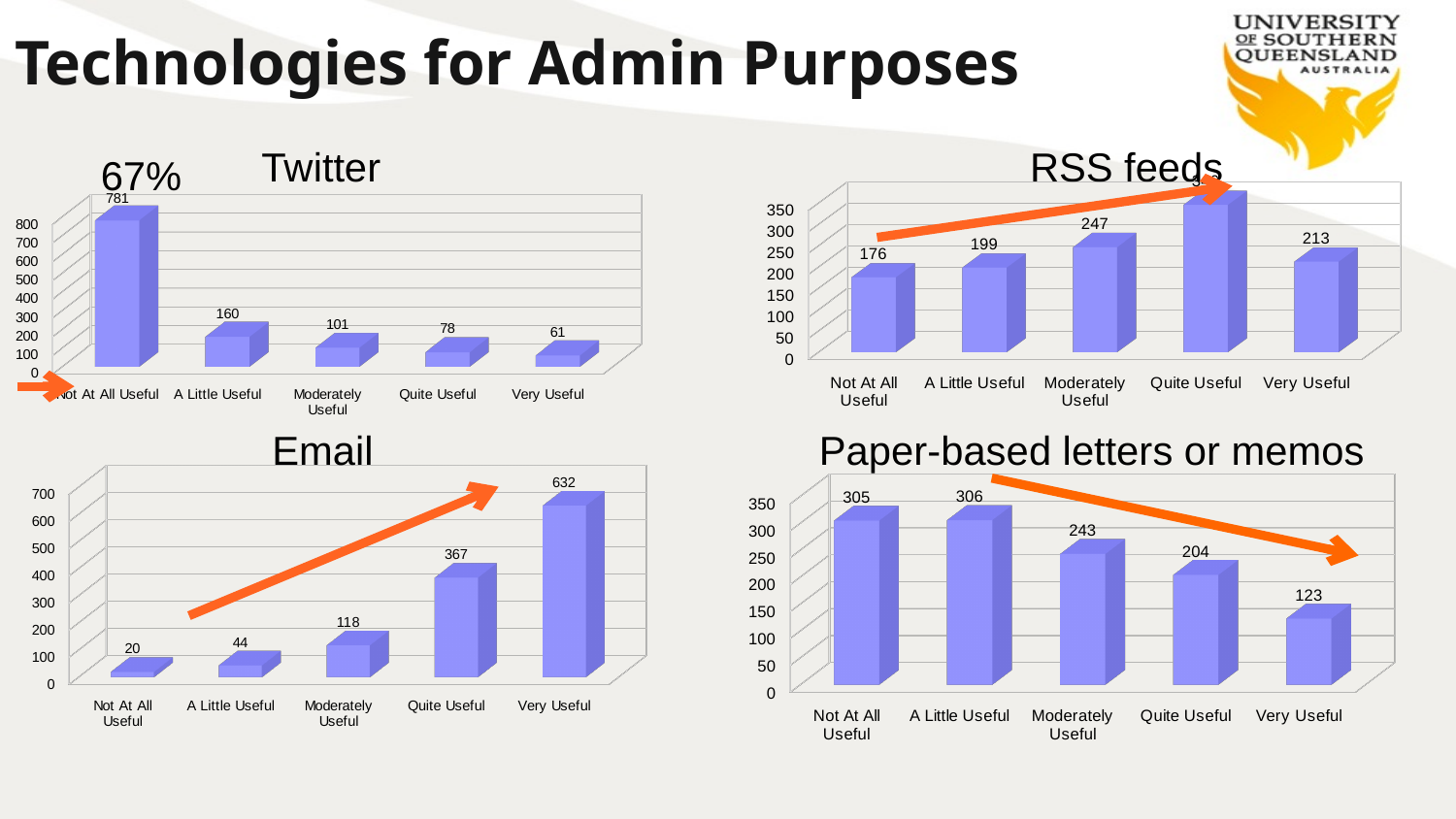
In the Email chart, what is the difference between the values for Very Useful and Quite Useful? 265 In the Paper-based letters or memos chart, which category has the lowest value? Very Useful In the RSS feeds chart, is the value for Quite Useful greater or less than 300? greater In the RSS feeds chart, what is the value for A Little Useful? 199 In the Paper-based letters or memos chart, what is the value for Moderately Useful? 243 How many categories are shown in the Email chart? 5 Do the values in the Email chart rise or fall from Not At All Useful to Very Useful? rise In the Email chart, which category has the lowest value? Not At All Useful In the Twitter chart, what is the difference between the values for Not At All Useful and A Little Useful? 621 In the Paper-based letters or memos chart, which is larger: the value for Quite Useful or the value for Very Useful? Quite Useful In the Twitter chart, what is the value for Not At All Useful? 781 In the Email chart, what is the value for Very Useful? 632